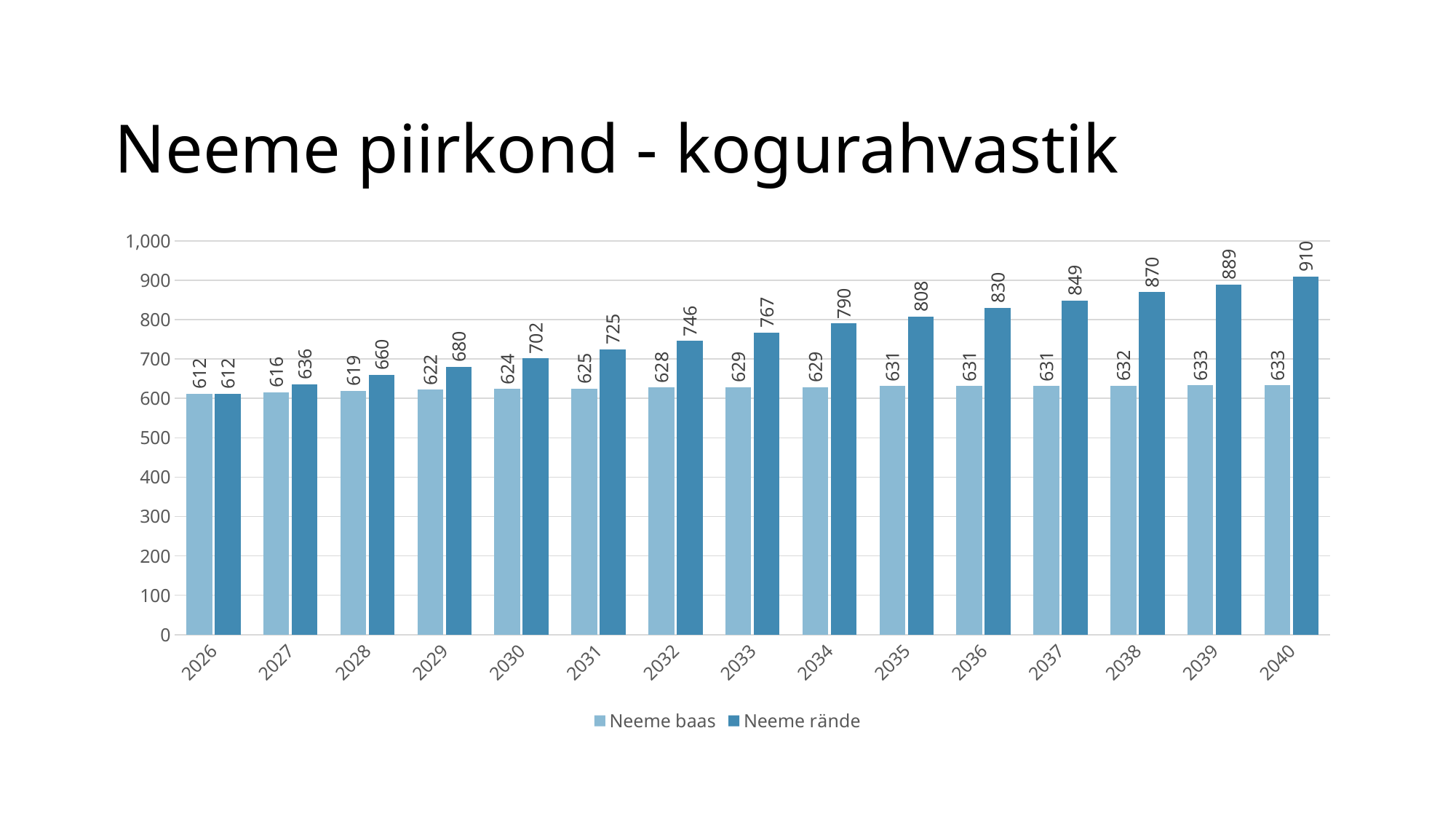
How many series does the legend list? 2 What is the value for Neeme rände in 2033? 767 Do the values for Neeme rände rise or fall from 2026 to 2040? Rise What is the value for Neeme baas in 2026? 612 What is the difference between Neeme rände and Neeme baas in 2040? 277 Is the value for Neeme rände in 2038 greater or less than 800? greater Which year has the lowest value for Neeme baas? 2026 How many years are shown on the x axis? 15 Which year has the highest value for Neeme rände? 2040 Which is larger in 2035: Neeme baas or Neeme rände? Neeme rände What kind of chart is shown on the slide? Bar chart What is the value for Neeme rände in 2040? 910